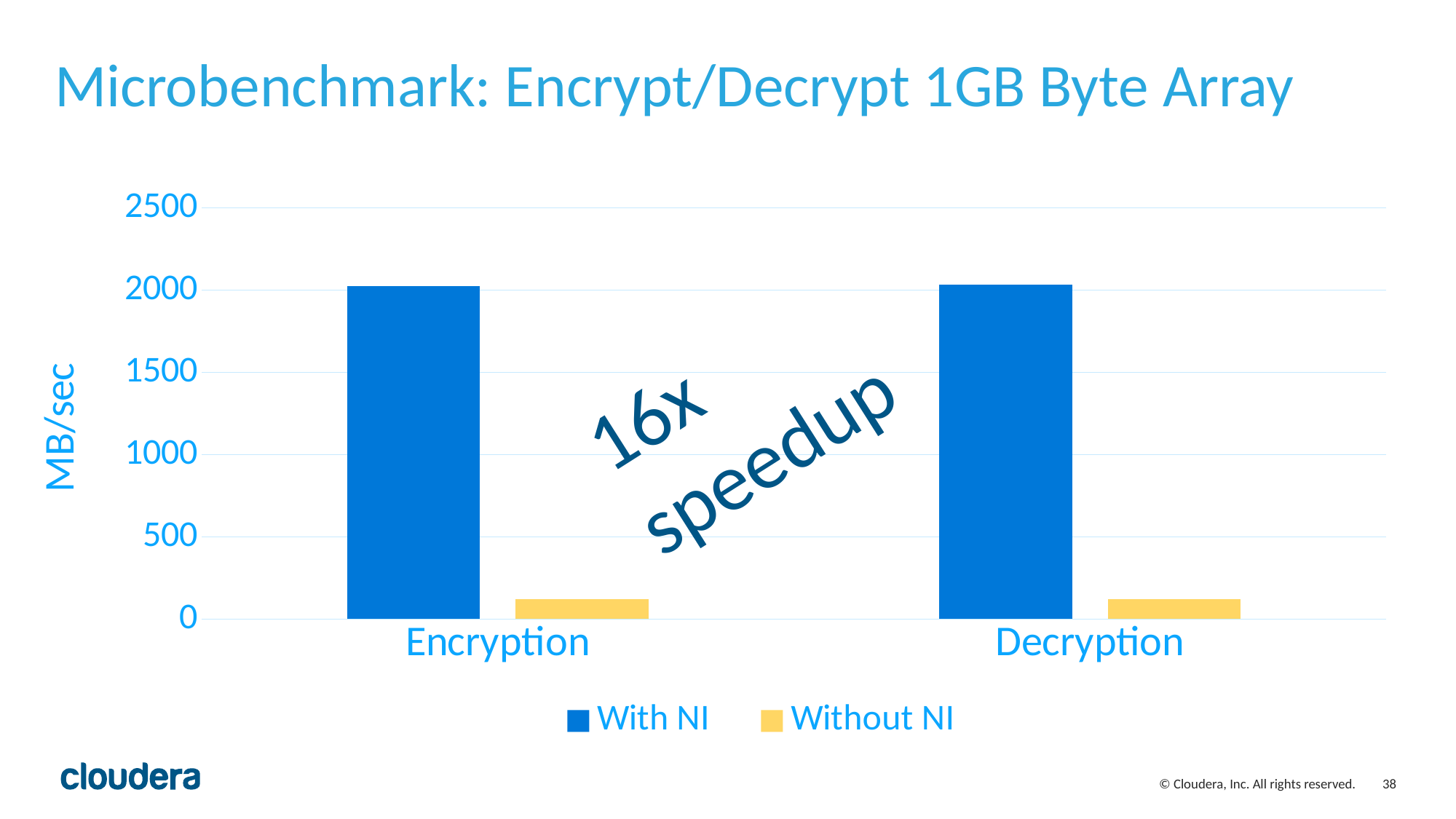
How many series does the chart's legend list? 2 Is the value for Without NI under Encryption greater or less than 500? less For Encryption, which series has the larger value, With NI or Without NI? With NI For Decryption, which series has the larger value, With NI or Without NI? With NI What is the label on the y axis of the chart? MB/sec Is the value for Without NI under Decryption greater or less than 500? less Is the value for With NI under Encryption greater or less than 1500? greater What speedup is annotated in the middle of the chart? 16x speedup What kind of chart is shown on the slide? bar chart How many categories are shown on the x axis of the chart? 2